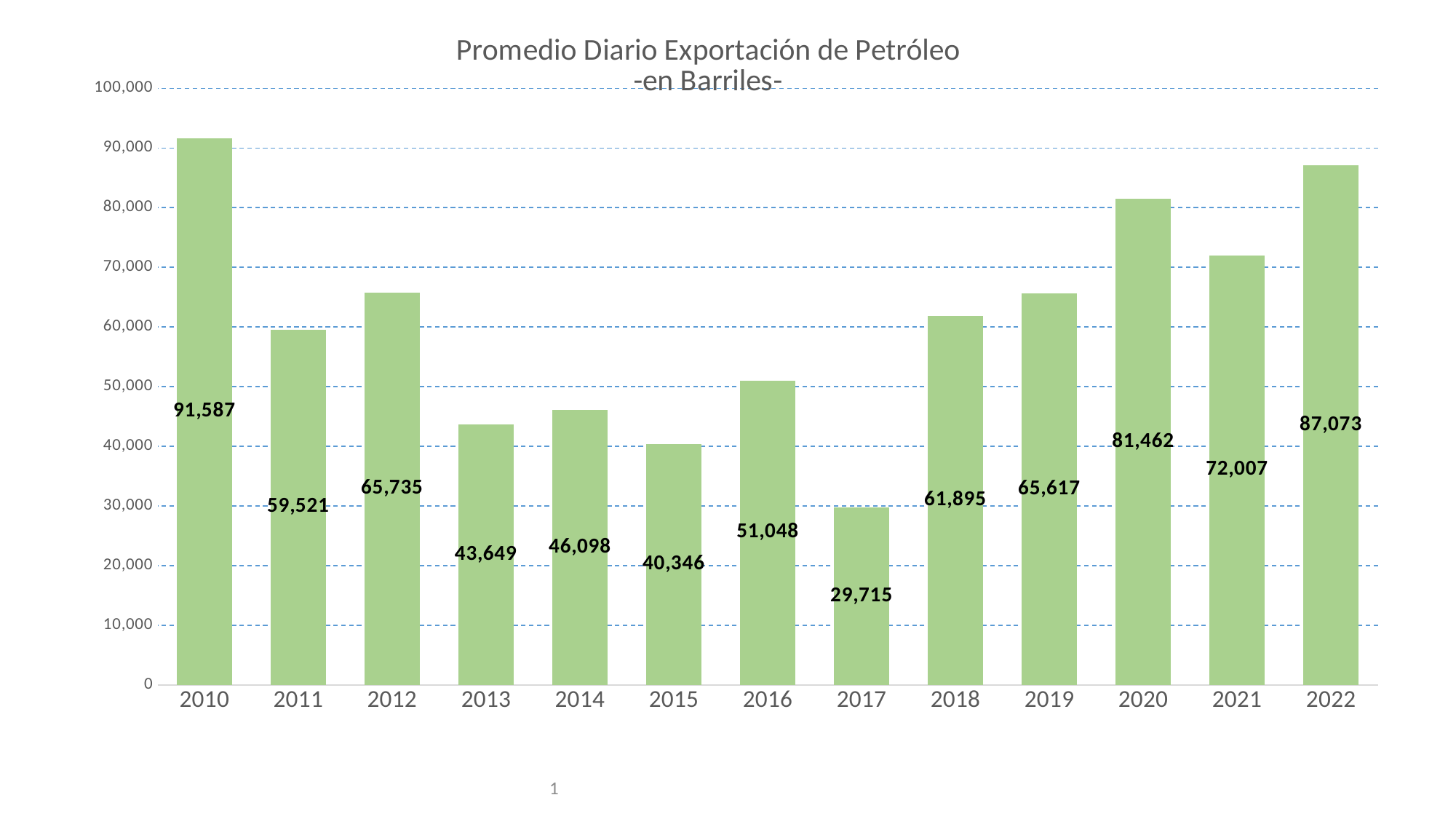
Do the values rise or fall from 2017 to 2022? rise What is the value for 2017? 29,715 Which year has the lowest value? 2017 How many years are shown on the x axis? 13 Which year has the highest value? 2010 What colour are the bars? green What is the value for 2020? 81,462 What kind of chart is this? bar chart Is the value for 2016 greater or less than 50,000? greater What is the title of the chart? Promedio Diario Exportación de Petróleo -en Barriles- What is the difference between the values for 2022 and 2021? 15,066 Which is larger, the value for 2012 or the value for 2019? 2012